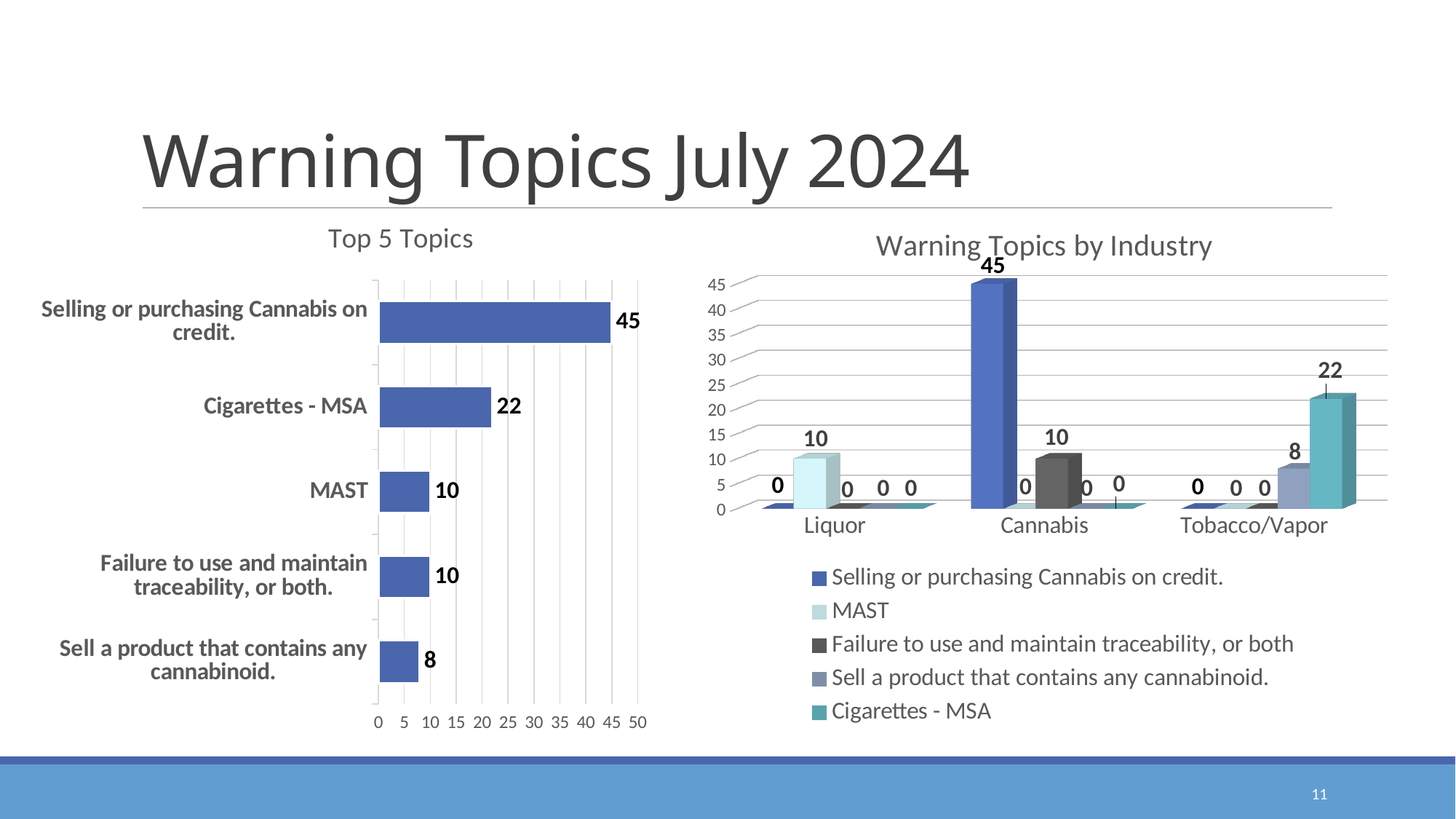
In the 'Warning Topics by Industry' chart, what is the total of all series for the Cannabis industry? 55 In the 'Warning Topics by Industry' chart, which is larger for Tobacco/Vapor: 'Sell a product that contains any cannabinoid.' or 'Cigarettes - MSA'? Cigarettes - MSA In the 'Top 5 Topics' chart, which topic has the lowest value? Sell a product that contains any cannabinoid. In the 'Top 5 Topics' chart, how many topics are shown? 5 What kind of chart is the 'Top 5 Topics' chart? Bar chart In the 'Warning Topics by Industry' chart, how many series does the legend list? 5 In the 'Warning Topics by Industry' chart, what is the value for MAST in the Liquor industry? 10 In the 'Top 5 Topics' chart, what is the value for 'Cigarettes - MSA'? 22 In the 'Top 5 Topics' chart, what is the difference between 'Selling or purchasing Cannabis on credit.' and 'Cigarettes - MSA'? 23 In the 'Warning Topics by Industry' chart, what is the value for 'Cigarettes - MSA' in the Tobacco/Vapor industry? 22 In the 'Warning Topics by Industry' chart, how many industries are shown on the x axis? 3 In the 'Top 5 Topics' chart, which topic has the highest value? Selling or purchasing Cannabis on credit.